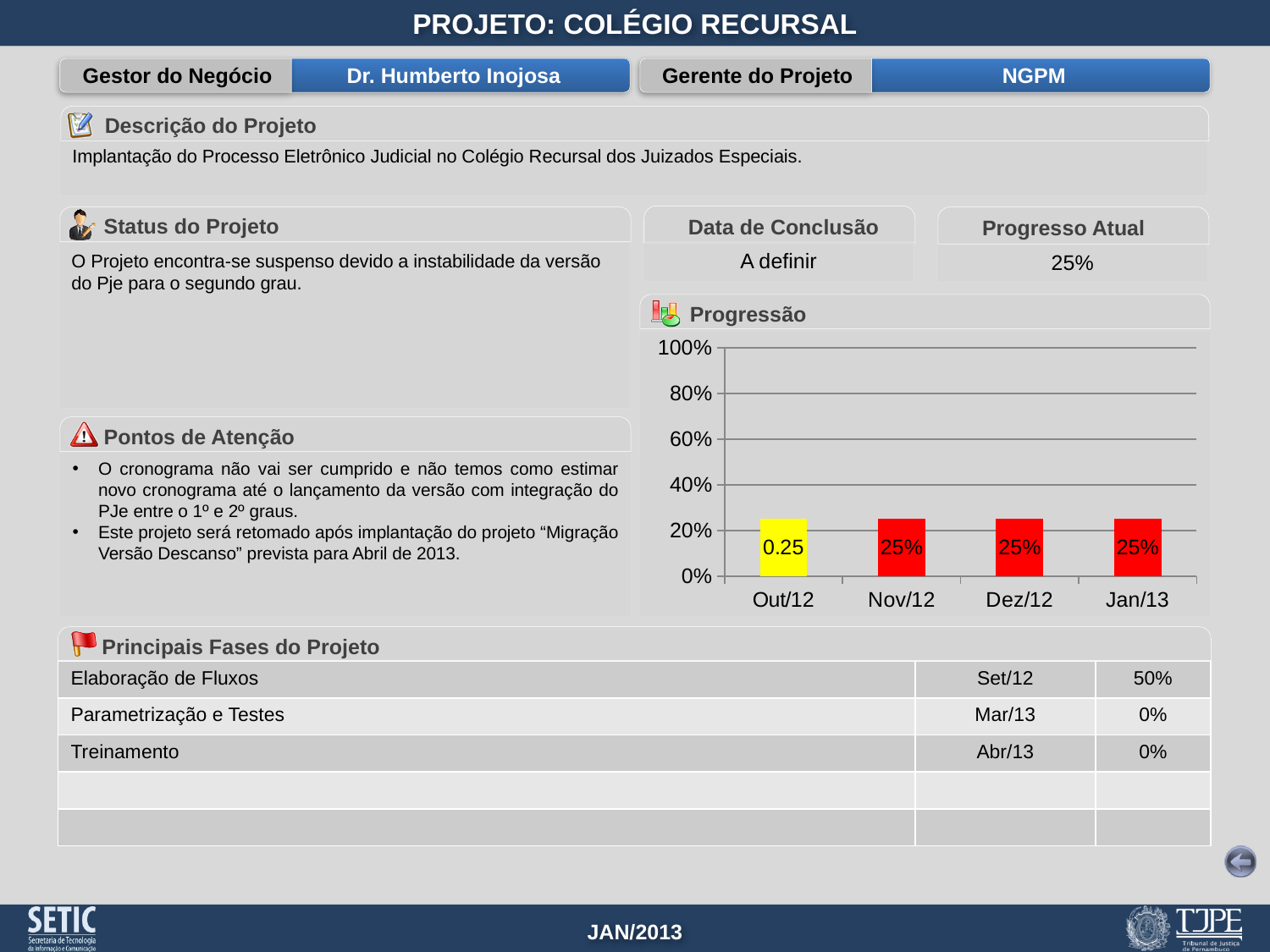
What is the value for Dez/12 in the Progressão chart? 25% What colour is the Out/12 bar in the Progressão chart? yellow What kind of chart is the Progressão chart? bar chart Is the value for Nov/12 in the Progressão chart greater or less than 20%? greater Is the value for Jan/13 in the Progressão chart greater or less than 40%? less What is the value for Jan/13 in the Progressão chart? 25% What is the highest value shown on the y axis of the Progressão chart? 100% Do the values in the Progressão chart rise, fall, or stay flat from Out/12 to Jan/13? stay flat What is the difference between the Nov/12 and Dez/12 values in the Progressão chart? 0% How many months (categories) are plotted in the Progressão chart? 4 What is the data label shown on the Out/12 bar in the Progressão chart? 0.25 What is the value for Nov/12 in the Progressão chart? 25%